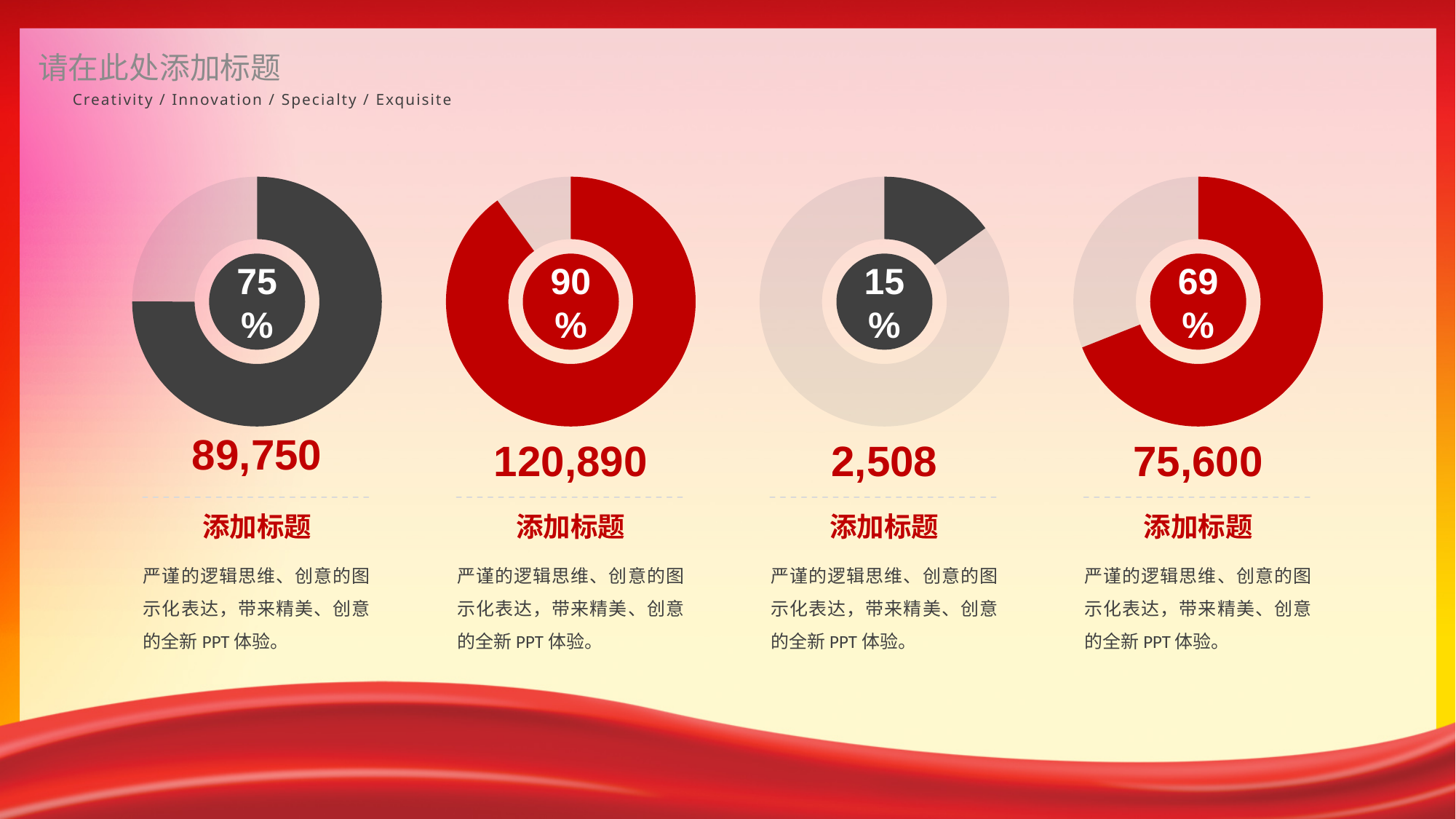
Which is larger: the percentage in the leftmost donut chart or the percentage in the rightmost donut chart? The leftmost (75%) What number is printed below the leftmost donut chart? 89,750 What percentage is shown in the centre of the second donut chart from the left? 90% What percentage is shown in the centre of the leftmost donut chart? 75% What is the difference between the percentage in the second donut chart and the percentage in the rightmost donut chart? 21% What percentage is shown in the centre of the third donut chart from the left? 15% What percentage is shown in the centre of the rightmost donut chart? 69% Which of the four donut charts shows the highest percentage? The second from the left (90%) What type of chart is used for the four figures on the slide? Donut chart Which of the four donut charts shows the lowest percentage? The third from the left (15%) What number is printed below the third donut chart from the left? 2,508 How many donut charts are on the slide? 4